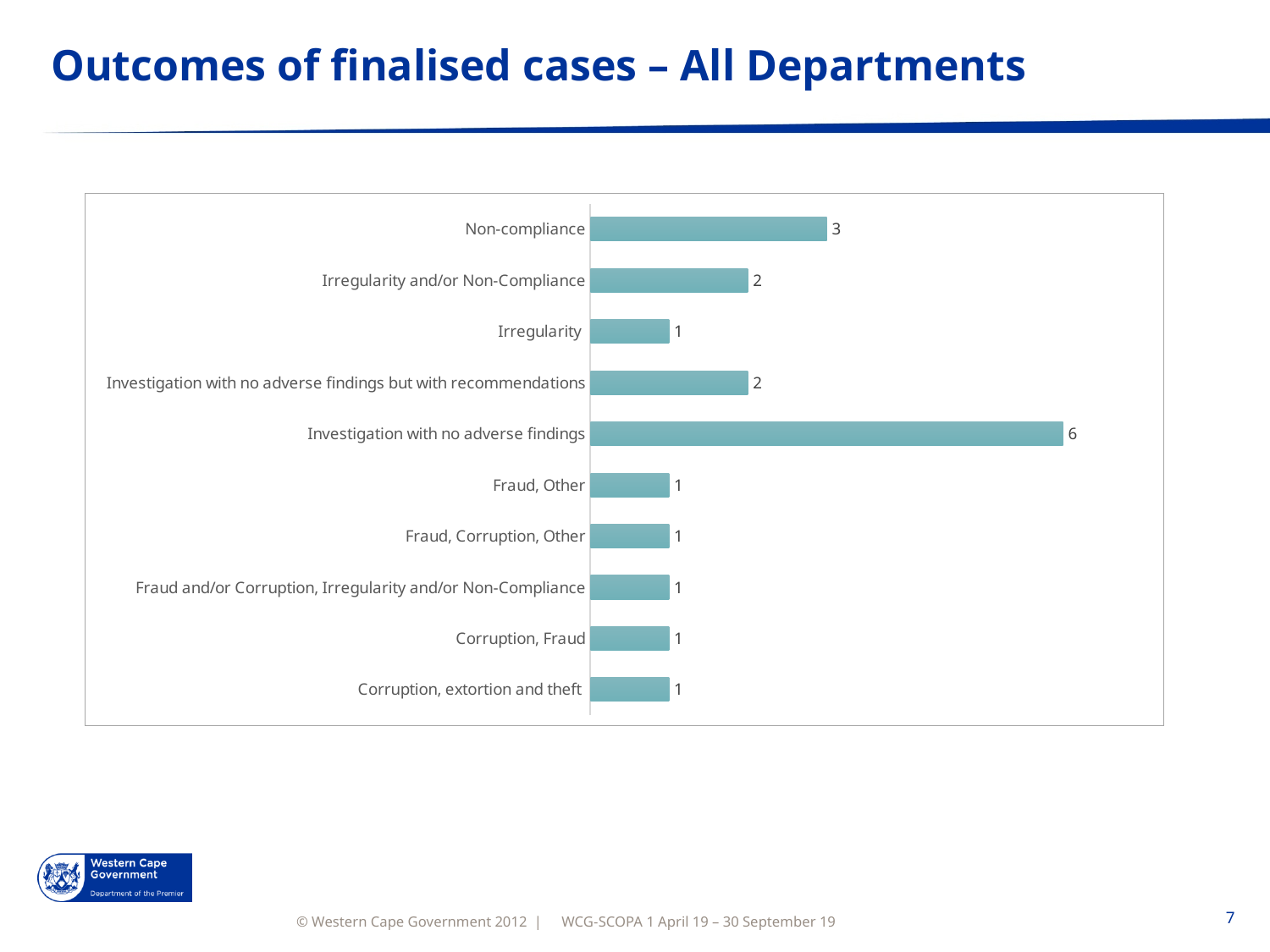
What is the difference between the values for Non-compliance and Irregularity? 2 What is the difference between the values for Investigation with no adverse findings and Non-compliance? 3 What is the title of the slide? Outcomes of finalised cases – All Departments What is the value for Investigation with no adverse findings? 6 What kind of chart is shown on the slide? Bar chart How many categories have a value of 1? 6 What is the value for Non-compliance? 3 Which is larger, the value for Non-compliance or the value for Investigation with no adverse findings but with recommendations? Non-compliance What is the value for Irregularity and/or Non-Compliance? 2 Which category has the highest value? Investigation with no adverse findings How many categories are shown in the chart? 10 What is the value for Corruption, extortion and theft? 1